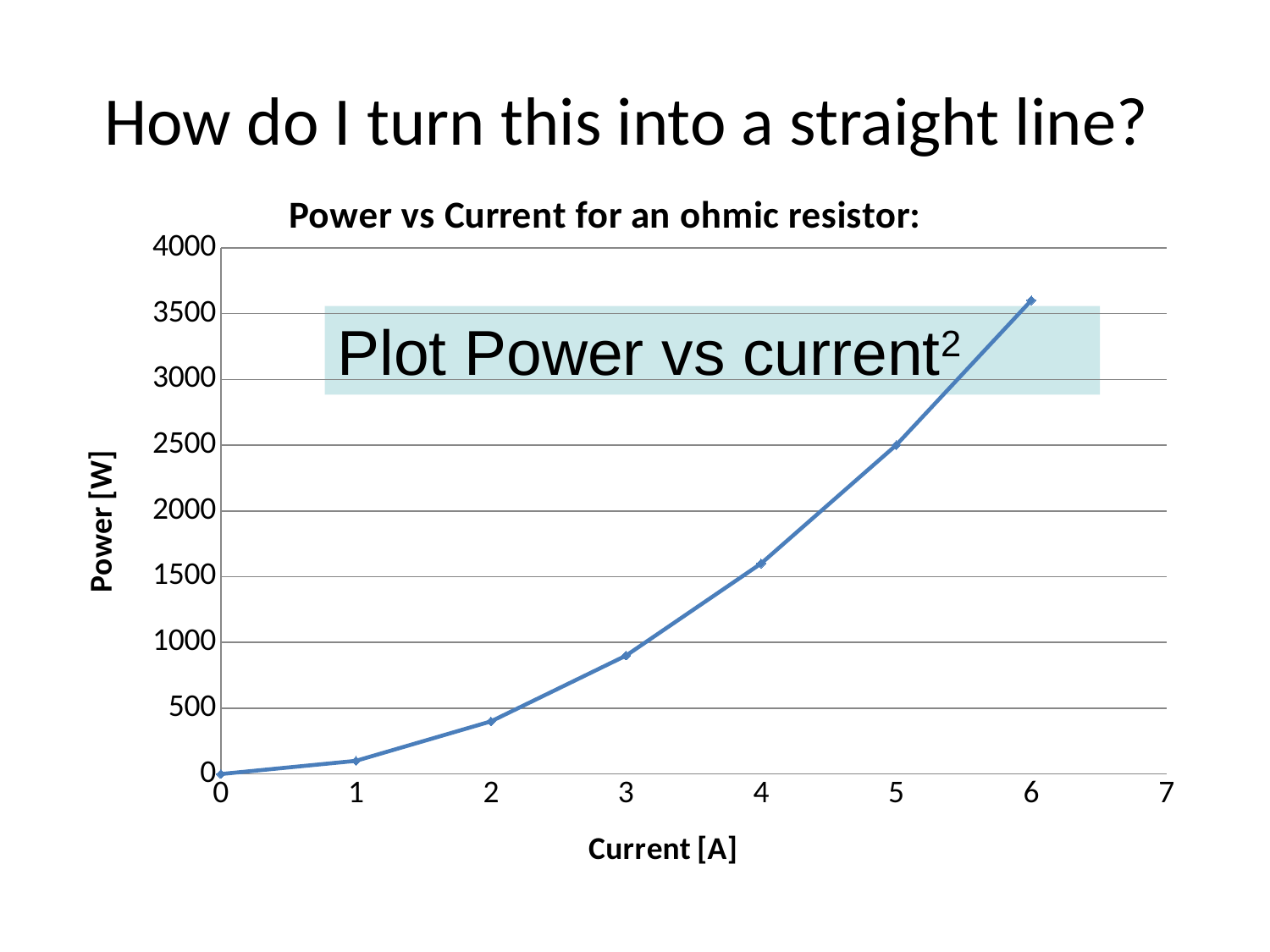
What is the power at a current of 5 A? 2500 How many data points are plotted on the line? 7 What is the label of the y axis? Power [W] What is the title of the chart? Power vs Current for an ohmic resistor: Does the power rise or fall as current increases along the x axis? rise Is the power at a current of 3 A greater or less than 1000? less What is the power at a current of 0 A? 0 At which current is the power highest? 6 Is the power at a current of 2 A greater or less than 500? less What kind of chart is shown on the slide? line chart Is the power at a current of 4 A greater or less than 1500? greater